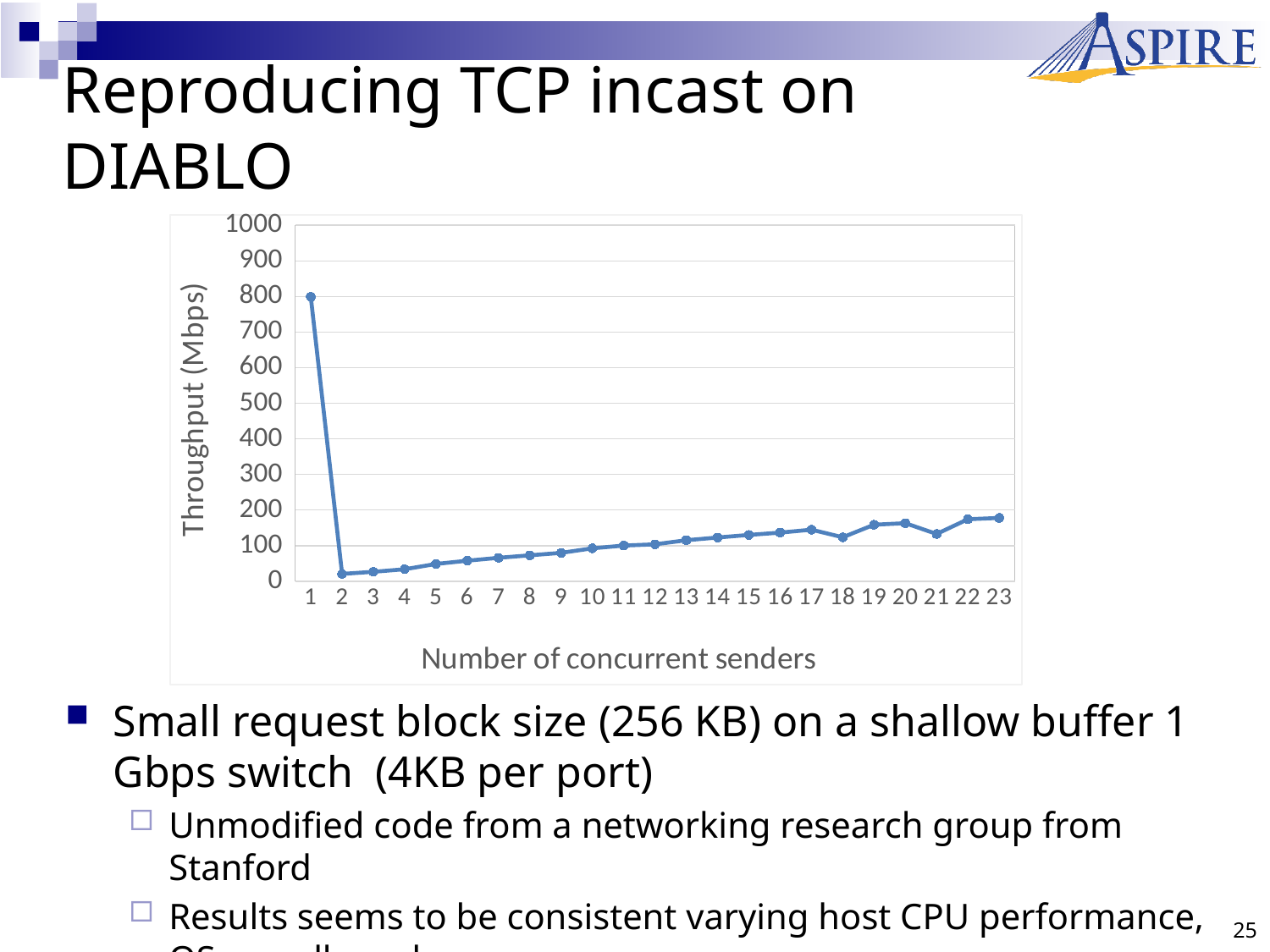
Is the throughput for 23 concurrent senders greater or less than 300 Mbps? less What kind of chart is shown on the slide? line chart Is the throughput for 2 concurrent senders greater or less than 100 Mbps? less What is the label of the x axis? Number of concurrent senders What is the label of the y axis? Throughput (Mbps) At which number of concurrent senders is throughput highest? 1 From 2 to 23 concurrent senders, does throughput generally rise or fall? rise Which has higher throughput: 1 concurrent sender or 23 concurrent senders? 1 concurrent sender Is the throughput for 1 concurrent sender greater or less than 700 Mbps? greater At which number of concurrent senders is throughput lowest? 2 How many data points are plotted on the line? 23